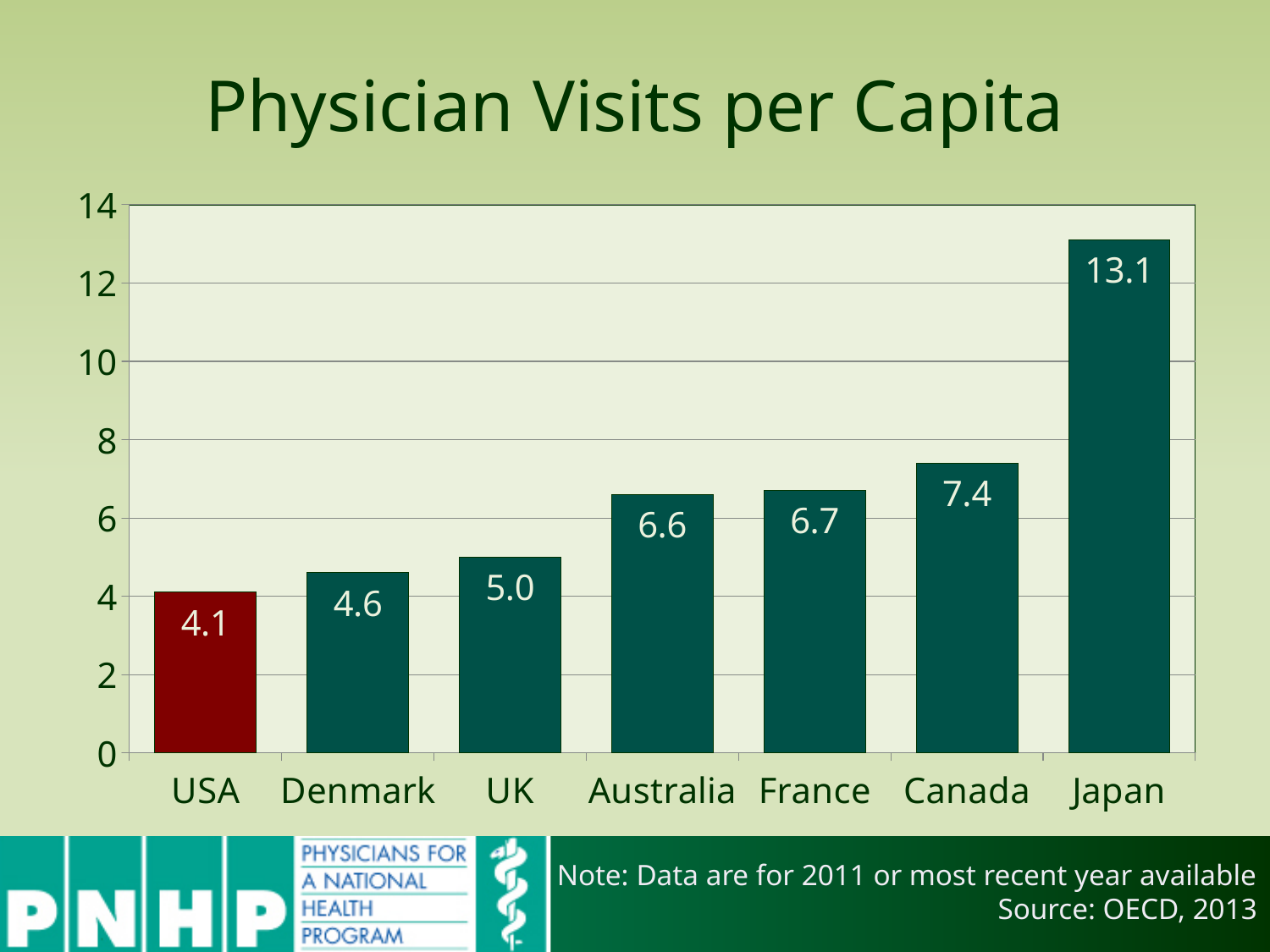
What kind of chart is shown on the slide? bar chart Which country has the lowest number of physician visits per capita? USA Which bar is coloured differently from the others? USA What is the difference between the values for Canada and Denmark? 2.8 How many countries are shown in the chart? 7 What is the difference between the values for Japan and the USA? 9.0 What is the value for Canada? 7.4 Which country has the highest number of physician visits per capita? Japan Is the value for Canada greater or less than 8? less Which is larger, the value for Australia or the value for UK? Australia What is the value for Japan? 13.1 What is the value for the USA? 4.1